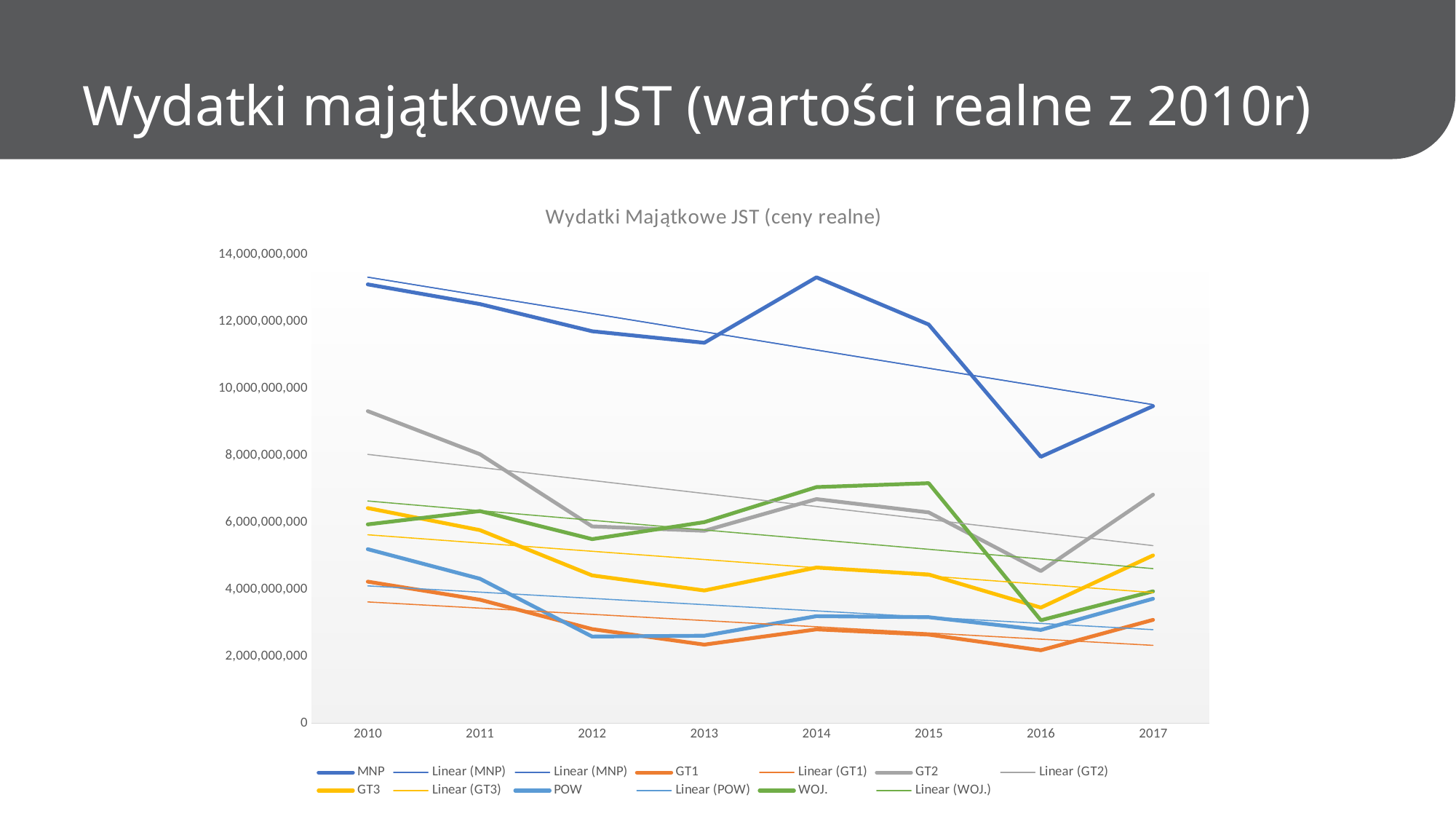
How many entries does the legend list? 13 Which is larger in 2010, GT2 or WOJ.? GT2 Does the GT2 series rise or fall overall from 2010 to 2017? fall Which series has the highest value in 2010? MNP How many years are plotted along the x axis? 8 Is the value for MNP in 2016 greater or less than 10,000,000,000? less What kind of chart is shown on the slide? line chart Is the value for MNP in 2010 greater or less than 12,000,000,000? greater Is the value for GT2 in 2010 greater or less than 8,000,000,000? greater What is the title of the chart? Wydatki Majątkowe JST (ceny realne) In which year is the MNP series at its lowest? 2016